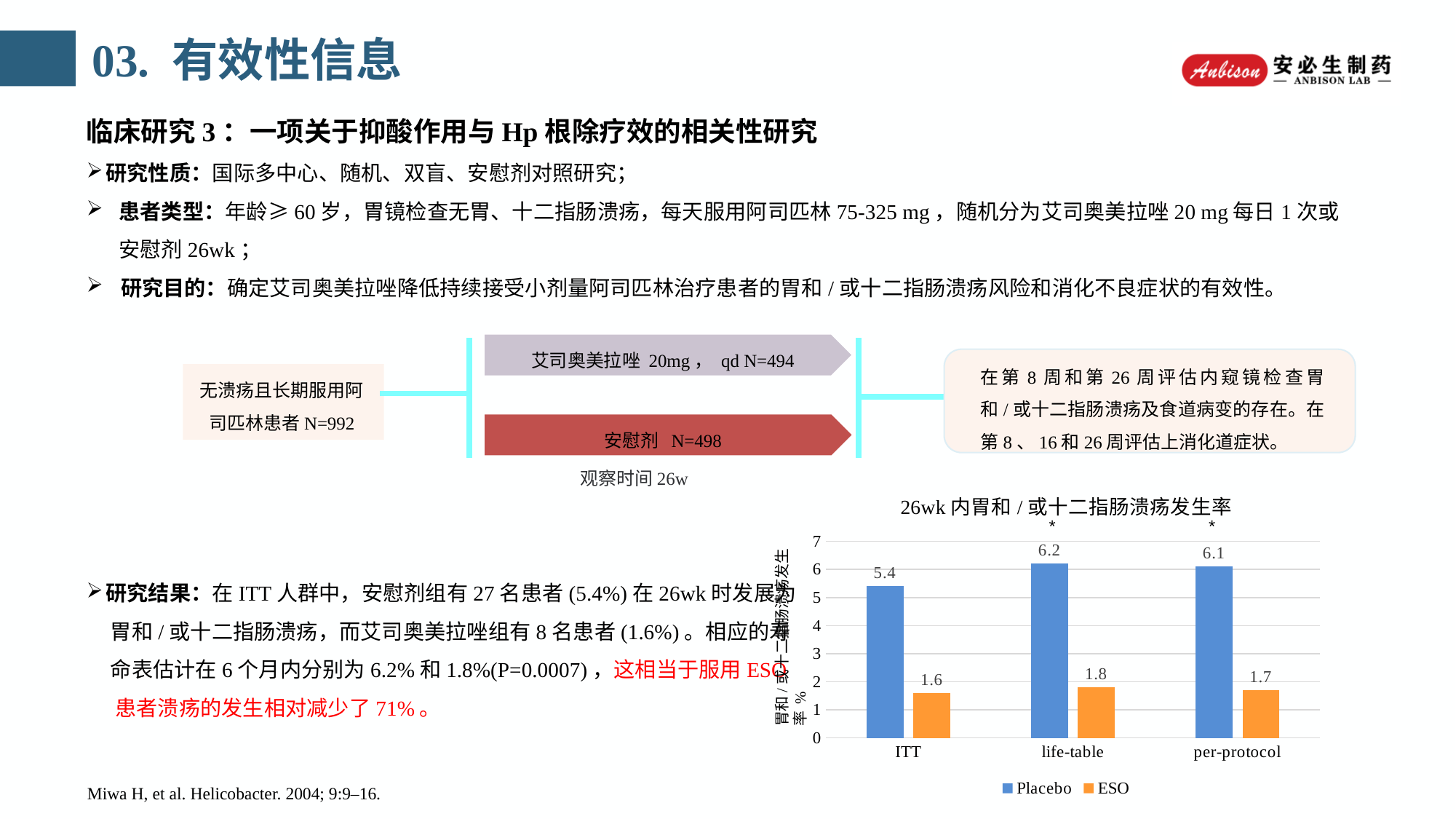
What is the difference between the Placebo and ESO values for ITT? 3.8 What kind of chart is shown on the slide? bar chart Which category has the highest Placebo value? life-table Which is larger for per-protocol, the Placebo value or the ESO value? Placebo How many series does the chart legend list? 2 What is the difference between the Placebo and ESO values for life-table? 4.4 Which category has the lowest ESO value? ITT What is the title of the chart? 26wk内胃和/或十二指肠溃疡发生率 What is the ESO value for per-protocol? 1.7 What is the Placebo value for ITT? 5.4 How many categories are shown on the x axis of the chart? 3 What is the ESO value for life-table? 1.8